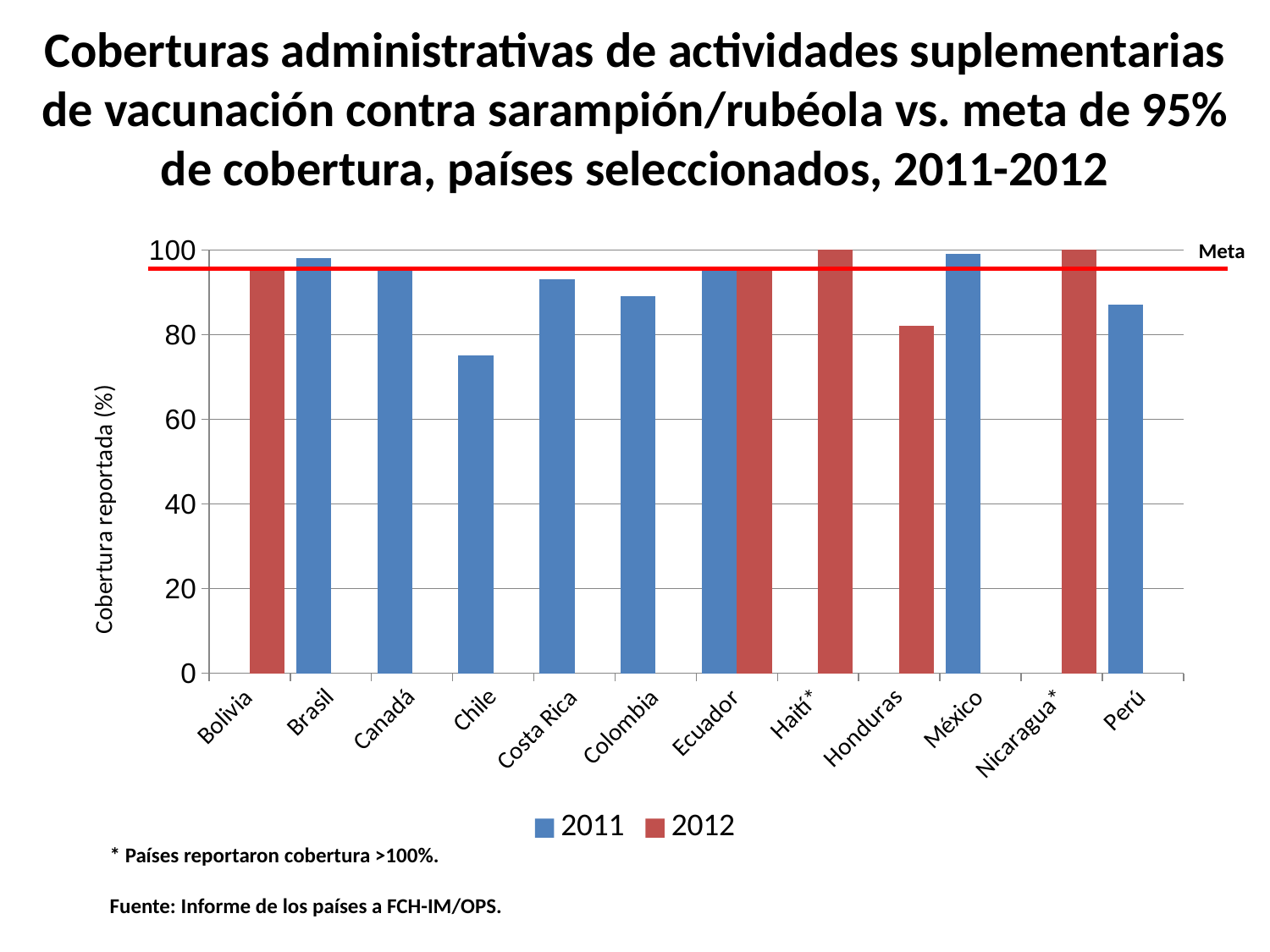
Is the 2011 value for Colombia greater or less than 80? greater What kind of chart is shown on the slide? bar chart How many series does the legend list? 2 Is the 2011 value for Perú greater or less than 90? less Which year is represented by the red bars according to the legend? 2012 Which is larger, the 2011 value for Brasil or the 2011 value for Perú? Brasil 2011 Is the 2011 value for Chile greater or less than 80? less How many countries are shown on the x axis? 12 Which country has the lowest reported coverage bar? Chile What label is given to the red horizontal line on the chart? Meta Which is larger, the 2011 value for Chile or the 2012 value for Honduras? Honduras 2012